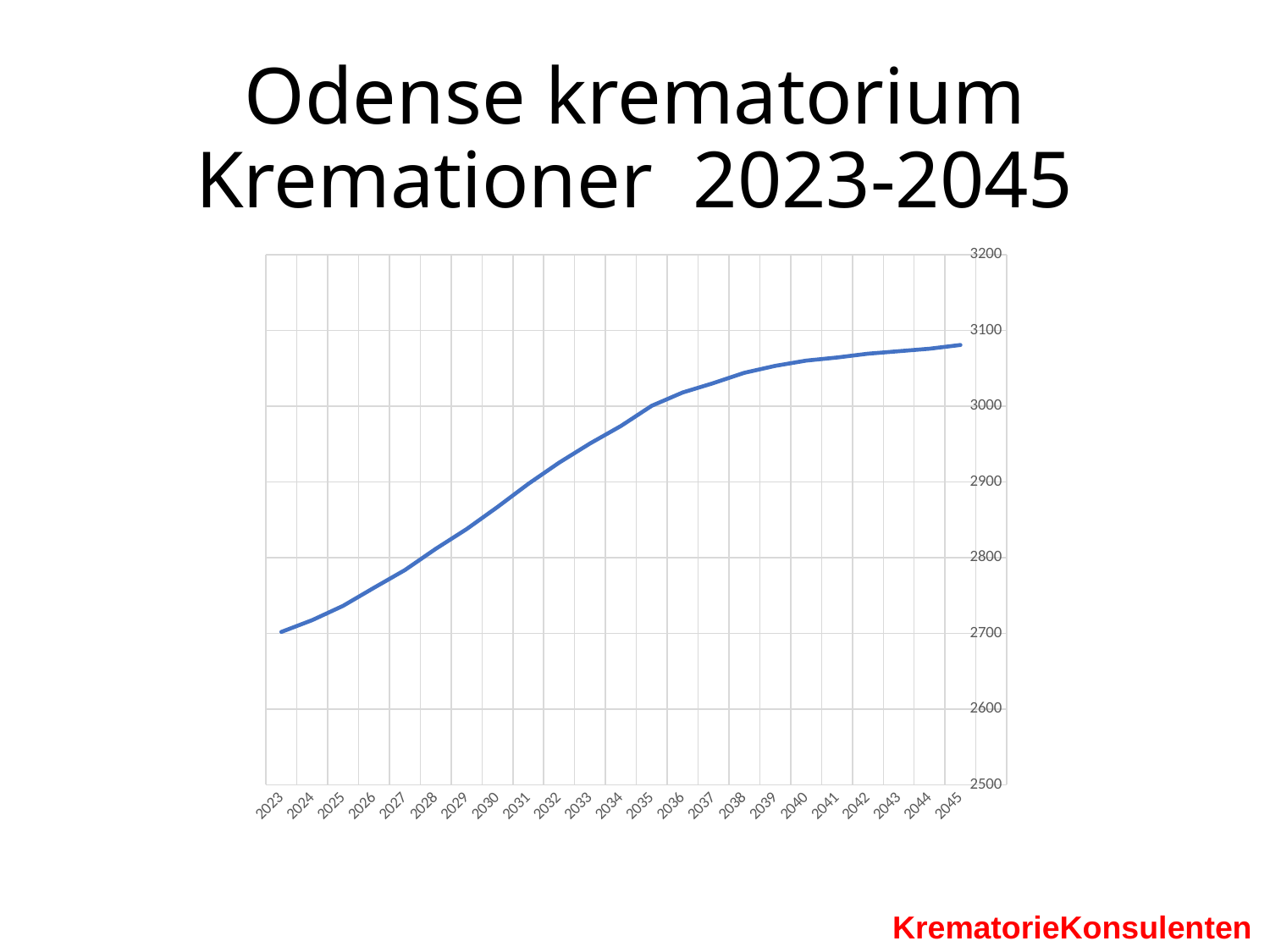
Is the value for 2027 greater or less than 2800? less Is the value for 2030 greater or less than 2800? greater How many years are plotted along the x axis? 23 Is the value for 2045 greater or less than 3100? less What kind of chart is shown on the slide? line chart Which year has the lowest value on the chart? 2023 What is the title of the slide above the chart? Odense krematorium Kremationer 2023-2045 Which year has the larger value, 2030 or 2040? 2040 Do the values rise or fall from 2023 to 2045? rise Which year has the highest value on the chart? 2045